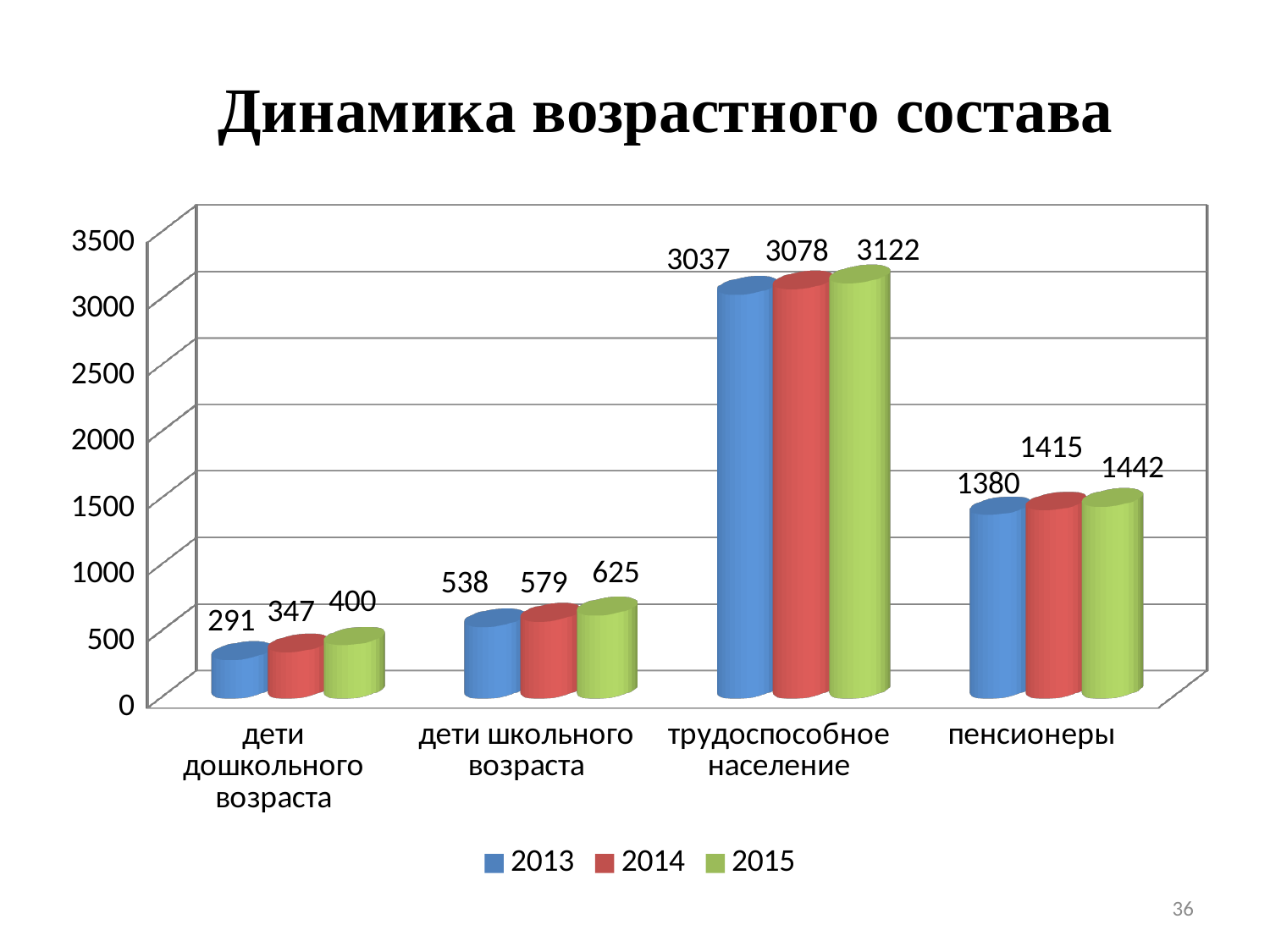
Do the values for пенсионеры rise or fall from 2013 to 2015? rise What is the value for пенсионеры in 2014? 1415 How many categories are shown on the x axis? 4 Which is larger: the 2014 value for пенсионеры or the 2014 value for дети школьного возраста? пенсионеры What is the title of the chart? Динамика возрастного состава How many series does the legend list? 3 What kind of chart is shown on the slide? bar chart What is the difference between the 2015 and 2013 values for дети школьного возраста? 87 What is the value for дети дошкольного возраста in 2013? 291 Which category has the lowest value in 2013? дети дошкольного возраста What is the value for трудоспособное население in 2015? 3122 Which category has the highest value in 2015? трудоспособное население